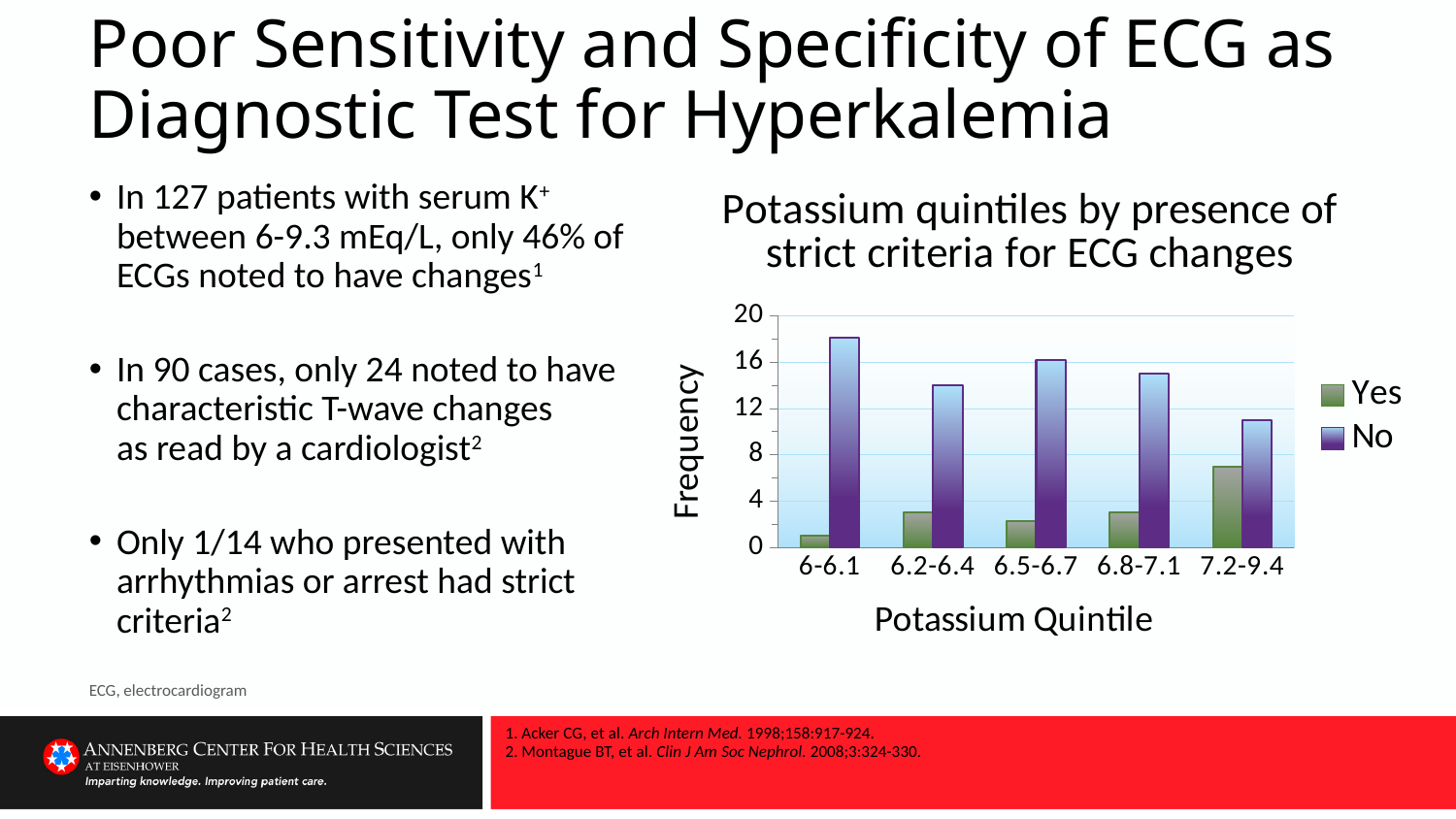
Which potassium quintile has the lowest 'No' frequency? 7.2-9.4 Which potassium quintile has the highest 'No' frequency? 6-6.1 How many potassium quintile categories are shown on the x axis? 5 How many series does the legend list? 2 Is the 'No' frequency for the 6-6.1 quintile greater or less than 16? greater Is the 'No' frequency for the 7.2-9.4 quintile greater or less than 12? less Which is larger: the 'No' frequency for 6-6.1 or the 'No' frequency for 6.2-6.4? 6-6.1 Is the 'Yes' frequency for the 7.2-9.4 quintile greater or less than 4? greater Which potassium quintile has the lowest 'Yes' frequency? 6-6.1 Which potassium quintile has the highest 'Yes' frequency? 7.2-9.4 What kind of chart is shown on the slide? bar chart What is the label of the y axis? Frequency